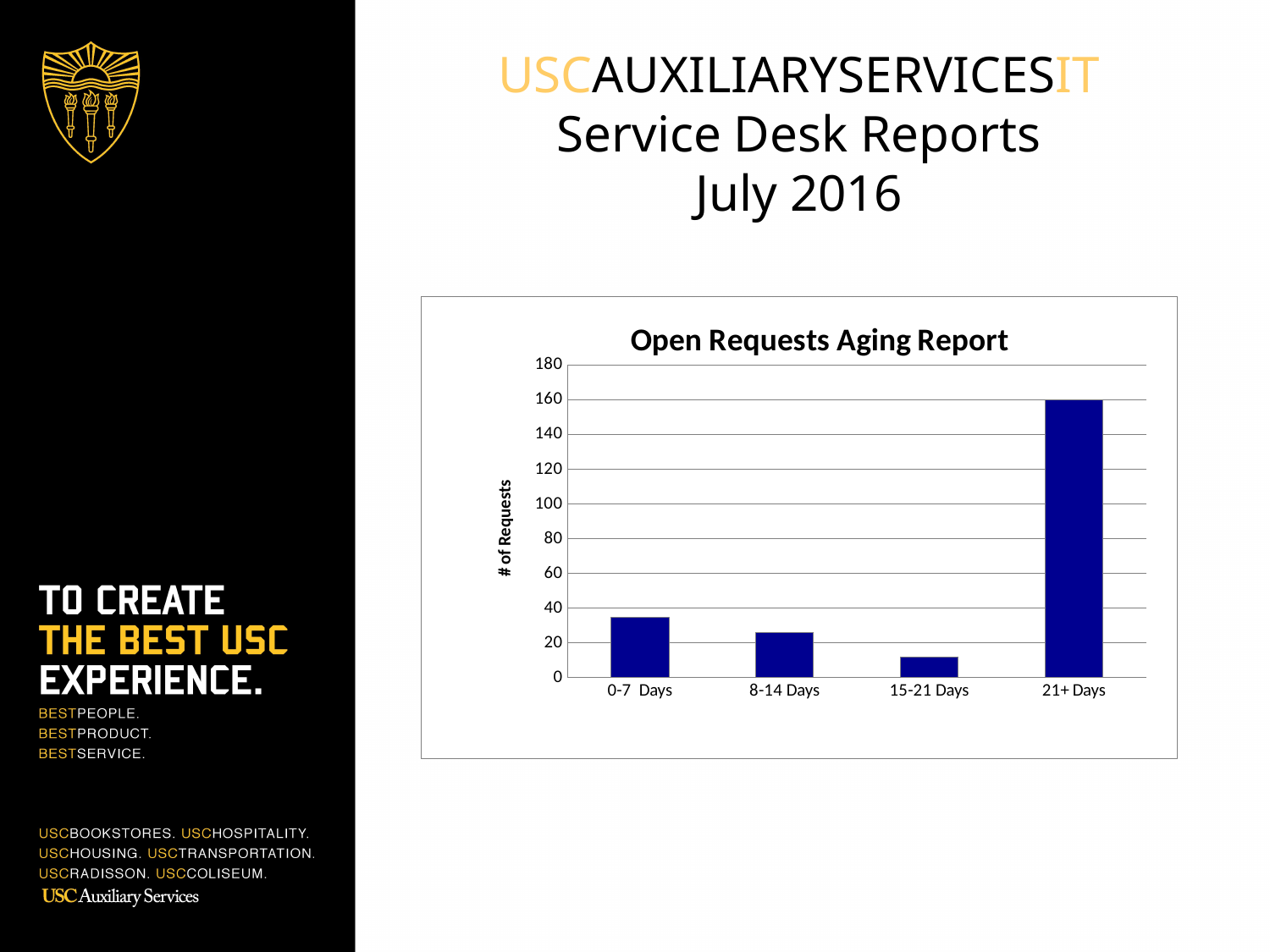
Is the value for 8-14 Days greater or less than 20? greater How many categories are shown on the x axis of the chart? 4 Is the value for 15-21 Days greater or less than 20? less Which category has the lowest number of requests? 15-21 Days What is the title of the chart? Open Requests Aging Report Which has more requests, 8-14 Days or 15-21 Days? 8-14 Days Which has more requests, 0-7 Days or 8-14 Days? 0-7 Days What kind of chart is shown on the slide? bar chart Is the value for 0-7 Days greater or less than 40? less Which category has the highest number of requests? 21+ Days What is the label on the vertical axis of the chart? # of Requests